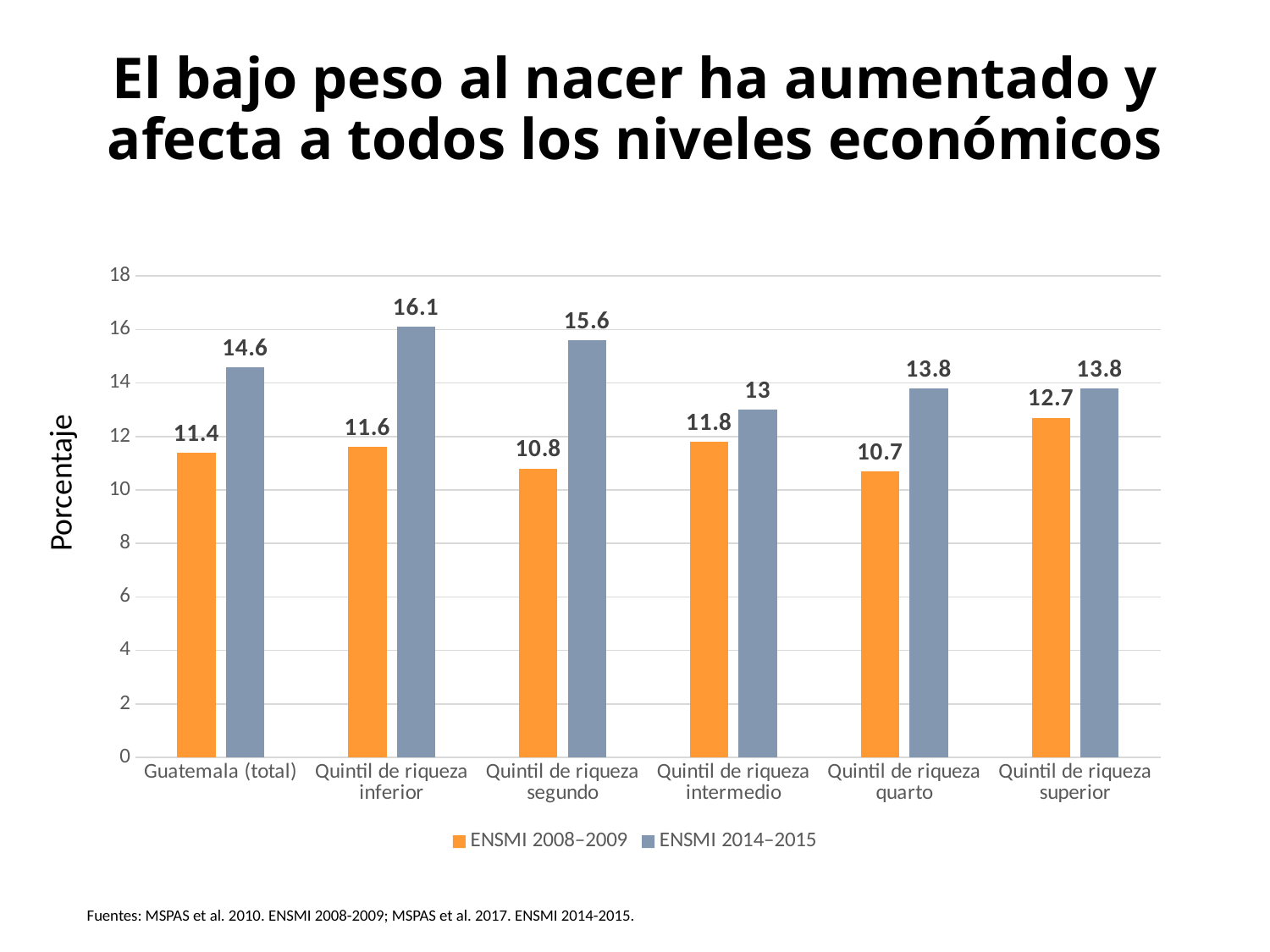
How many series does the legend list? 2 Which category has the lowest ENSMI 2008–2009 value? Quintil de riqueza quarto Which colour represents the ENSMI 2008–2009 series? Orange Is the ENSMI 2014–2015 value for Quintil de riqueza intermedio greater or less than 12? greater Which category has the highest ENSMI 2014–2015 value? Quintil de riqueza inferior Which is larger for Quintil de riqueza superior: the ENSMI 2008–2009 value or the ENSMI 2014–2015 value? ENSMI 2014–2015 What is the label of the y axis? Porcentaje How many categories are shown on the x axis? 6 What is the ENSMI 2008–2009 value for Quintil de riqueza quarto? 10.7 What kind of chart is shown on the slide? Bar chart What is the difference between the ENSMI 2014–2015 and ENSMI 2008–2009 values for Quintil de riqueza segundo? 4.8 What is the ENSMI 2014–2015 value for Guatemala (total)? 14.6